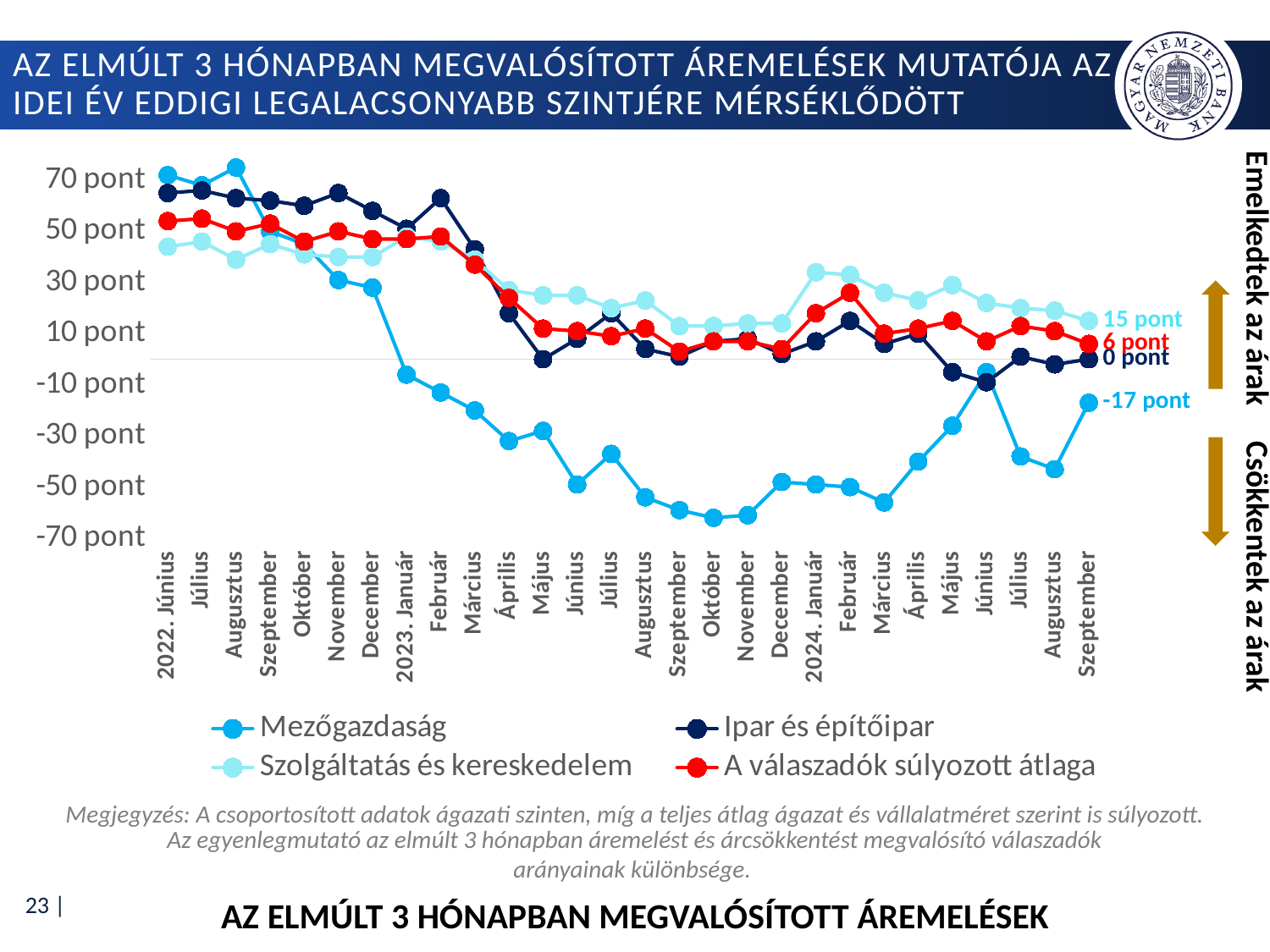
Is the value for Mezőgazdaság in 2023 Október greater or less than -50 pont? less In 2024 Szeptember, which is larger: Mezőgazdaság or Ipar és építőipar? Ipar és építőipar What kind of chart is shown on the slide? line chart What is the difference between Szolgáltatás és kereskedelem and Mezőgazdaság in 2024 Szeptember? 32 pont What is the value for Szolgáltatás és kereskedelem in 2024 Szeptember? 15 pont What is the value for Mezőgazdaság in 2024 Szeptember? -17 pont Does the Mezőgazdaság series rise or fall from 2022 Június to 2023 Október? fall What is the value for Ipar és építőipar in 2024 Szeptember? 0 pont How many series does the legend list? 4 Which series has the lowest value in 2024 Szeptember? Mezőgazdaság What is the value for A válaszadók súlyozott átlaga in 2024 Szeptember? 6 pont Which series has the highest value in 2024 Szeptember? Szolgáltatás és kereskedelem